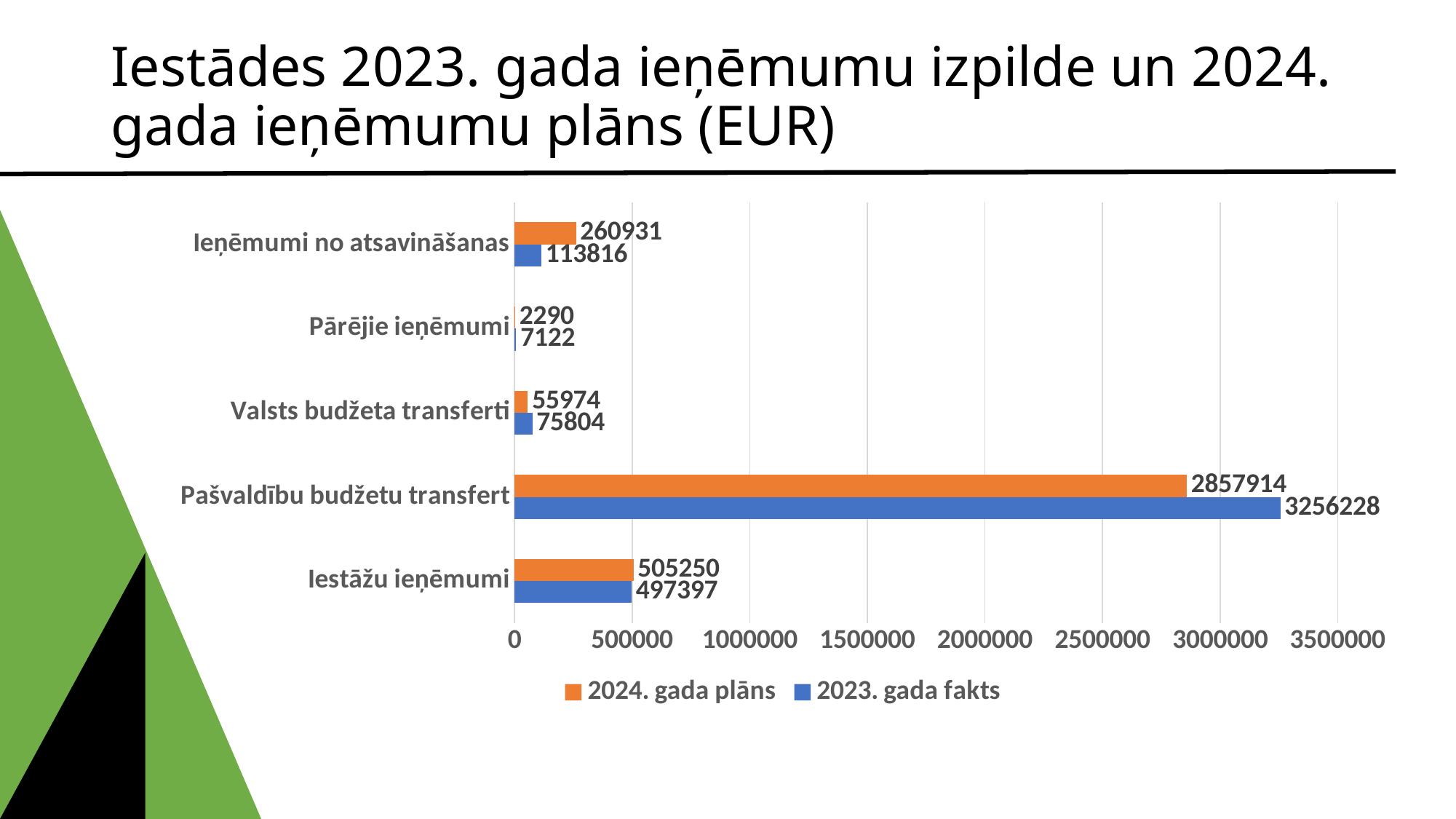
Is the 2023. gada fakts value for Pašvaldību budžetu transfert greater or less than 3000000? greater What is the 2024. gada plāns value for Valsts budžeta transferti? 55974 What is the 2024. gada plāns value for Pašvaldību budžetu transfert? 2857914 What is the 2023. gada fakts value for Iestāžu ieņēmumi? 497397 What is the 2023. gada fakts value for Ieņēmumi no atsavināšanas? 113816 What kind of chart is shown on the slide? bar chart Which category has the lowest 2024. gada plāns value? Pārējie ieņēmumi Which category has the highest 2023. gada fakts value? Pašvaldību budžetu transfert What is the difference between the 2023. gada fakts and 2024. gada plāns values for Pašvaldību budžetu transfert? 398314 How many series does the legend list? 2 For Ieņēmumi no atsavināšanas, which is larger: the 2024. gada plāns or the 2023. gada fakts value? 2024. gada plāns How many categories are shown on the chart? 5